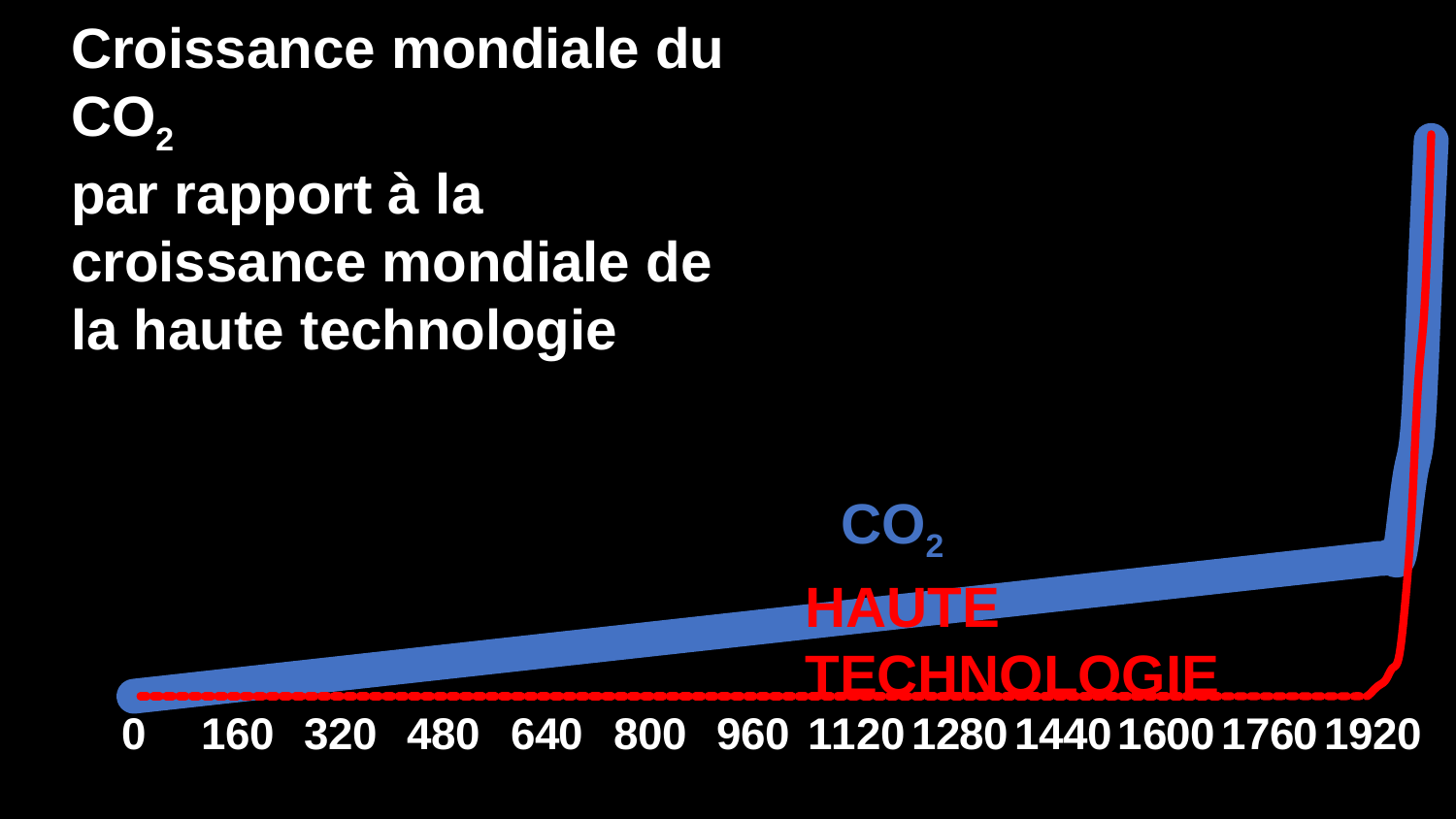
How many tick labels are shown on the x axis? 13 What colour is the CO2 line on the chart? blue Does the CO2 series rise or fall as you move from left to right along the x axis? rises Which series stays flat near the bottom of the chart for most of the x axis before rising sharply at the far right? HAUTE TECHNOLOGIE What is the first tick label on the x axis? 0 What are the names of the two series plotted on the chart? CO2 and HAUTE TECHNOLOGIE At the x-axis value 960, which series is higher, CO2 or HAUTE TECHNOLOGIE? CO2 What kind of chart is shown on the slide? line chart Which series rises steadily from the very start of the x axis? CO2 What is the interval between consecutive tick labels on the x axis? 160 How many data series are plotted on the chart? 2 What is the last tick label on the x axis? 1920